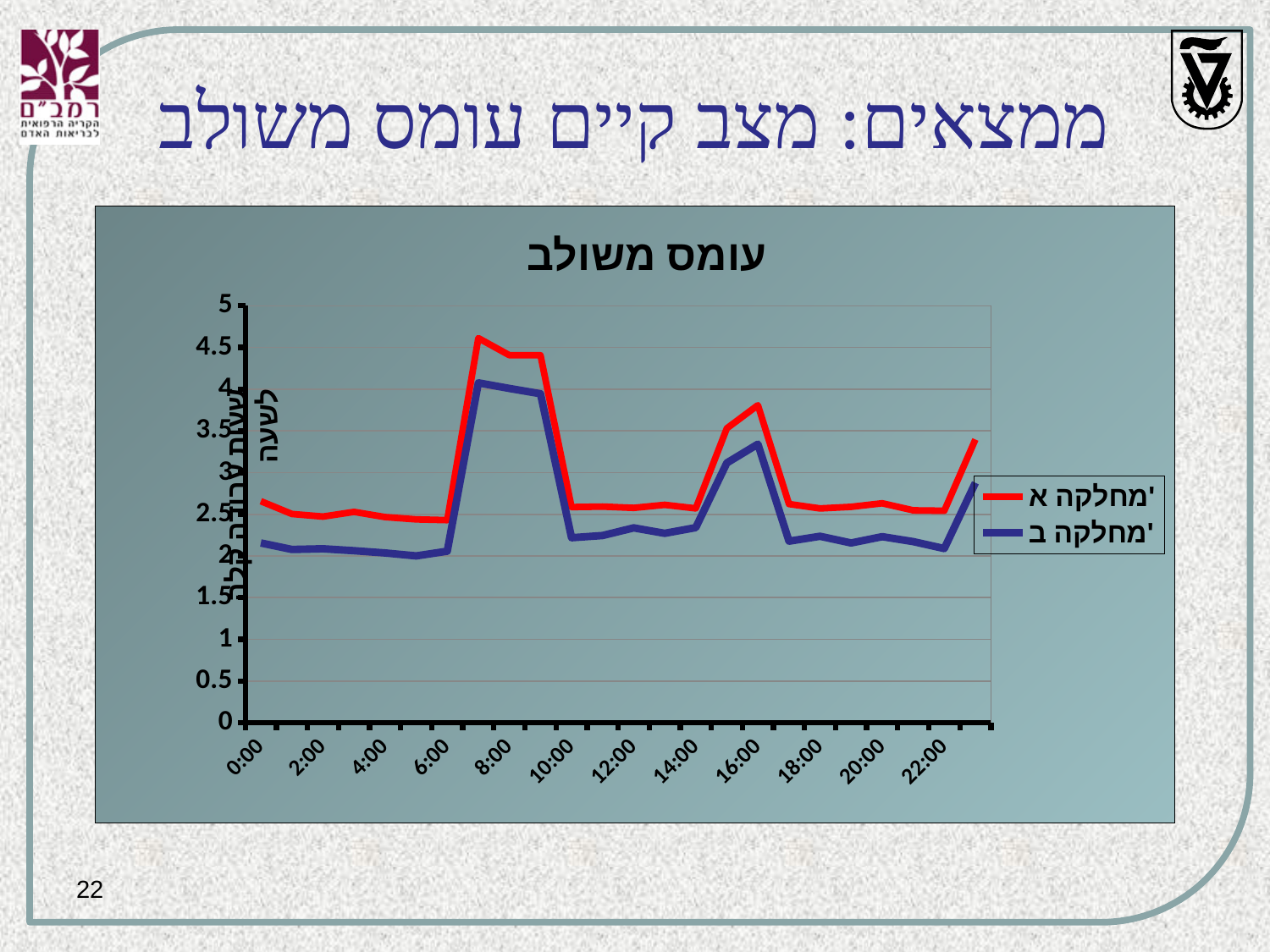
Is the value for מחלקה א' at 8:00 greater or less than 4? greater How many series does the legend list? 2 At 8:00, which series has the higher value, מחלקה א' or מחלקה ב'? מחלקה א' Is the value for מחלקה ב' at 16:00 greater or less than 3.5? less Is the value for מחלקה א' at 16:00 greater or less than 3.5? greater Do the values for מחלקה א' rise or fall between 6:00 and 8:00? rise Which series reaches the highest value on the chart? מחלקה א' Which series is drawn in red? מחלקה א' What is the title of the chart? עומס משולב What kind of chart is shown on the slide? line chart